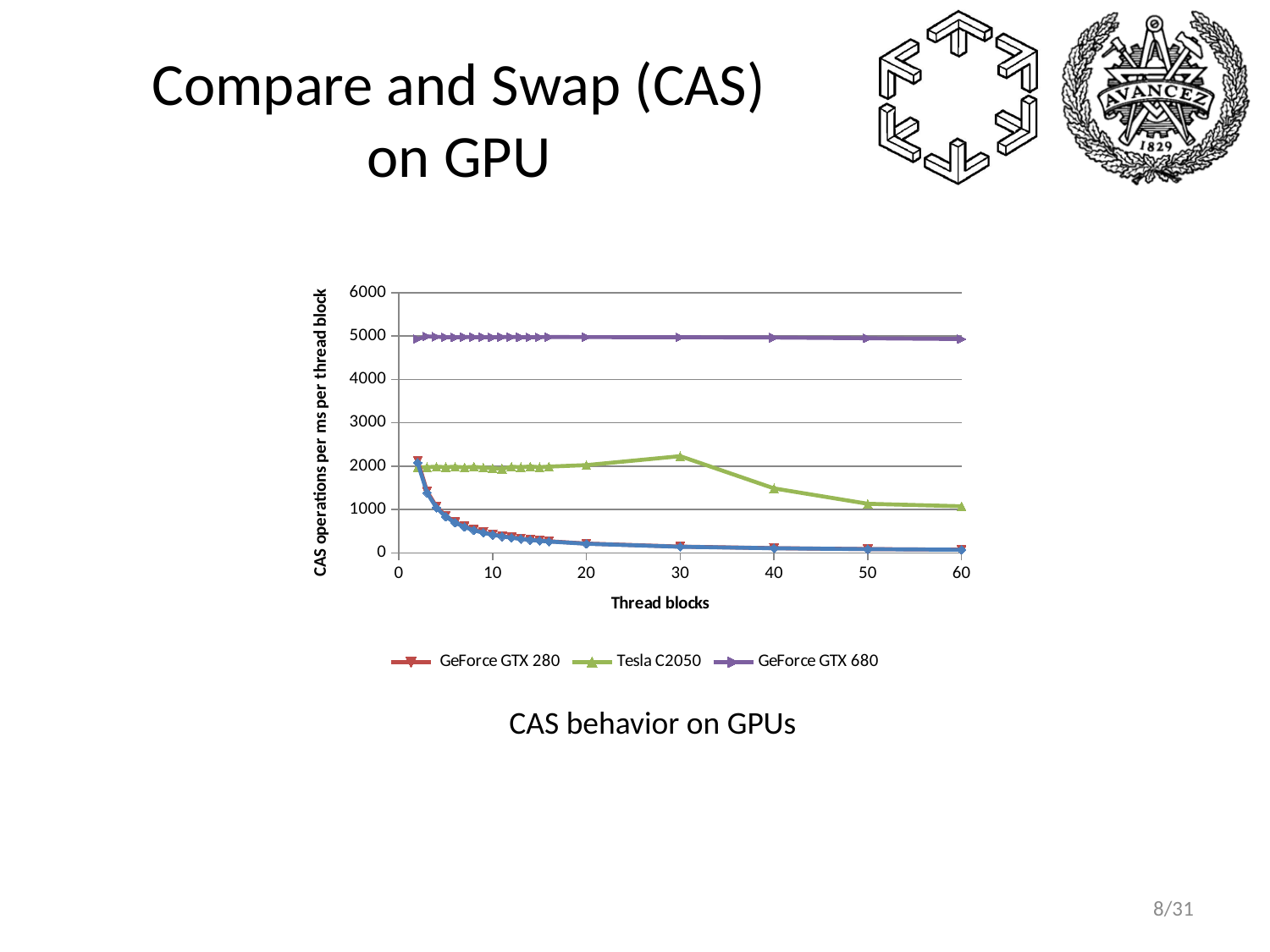
Which series has the highest CAS operations per ms per thread block across the chart? GeForce GTX 680 Is the value for Tesla C2050 at 30 thread blocks greater or less than 1000? greater How many series does the legend list? 3 Which series has the lowest CAS operations per ms per thread block at 60 thread blocks? GeForce GTX 280 What is the label of the y axis? CAS operations per ms per thread block Is the value for GeForce GTX 280 at 20 thread blocks greater or less than 1000? less Is the value for GeForce GTX 680 at 30 thread blocks greater or less than 4000? greater What kind of chart is shown on the slide? line chart Does the value for GeForce GTX 280 rise or fall as the number of thread blocks increases? fall What is the label of the x axis? Thread blocks At 40 thread blocks, which series has the larger value: Tesla C2050 or GeForce GTX 280? Tesla C2050